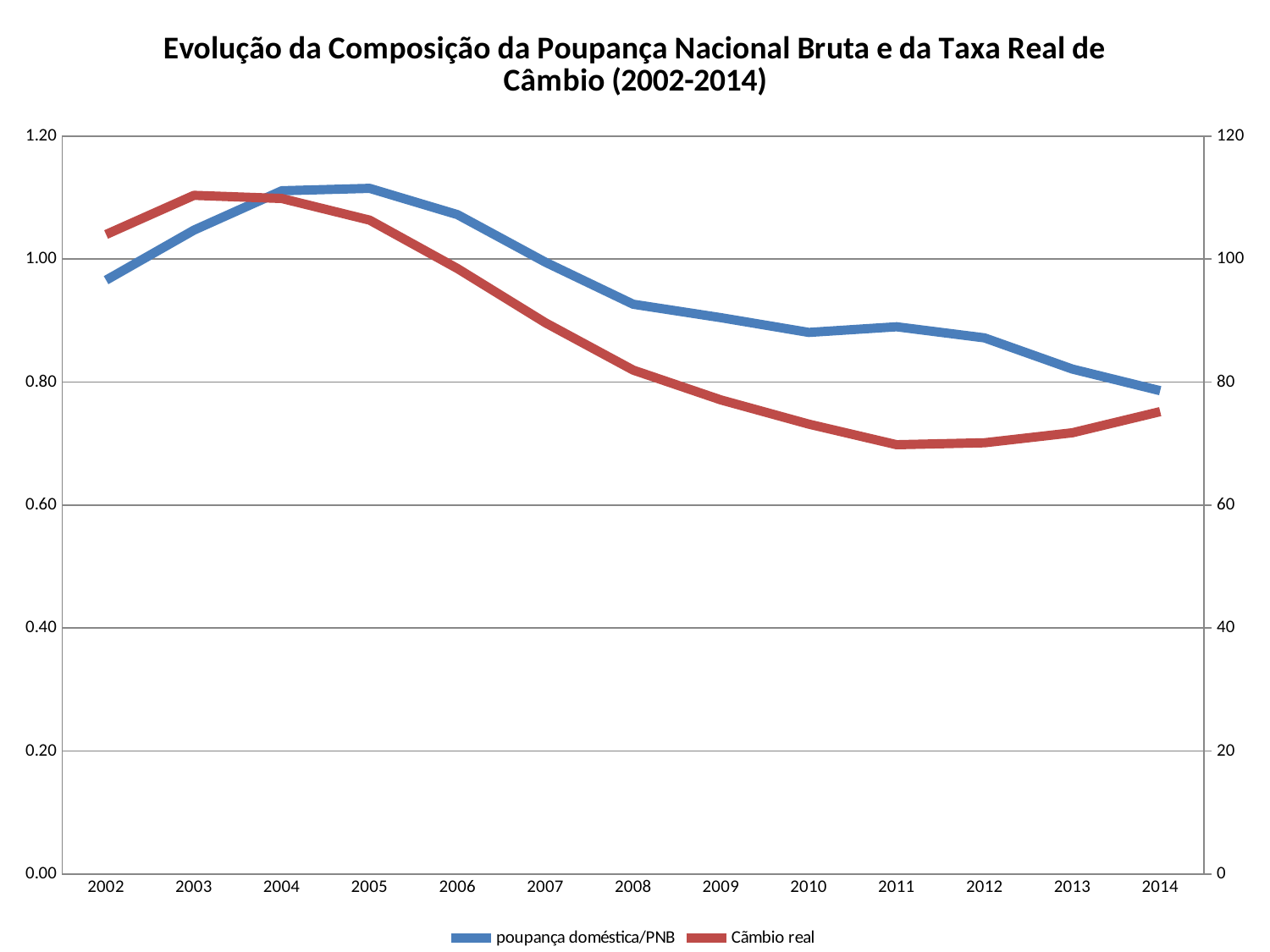
Is the value of poupança doméstica/PNB in 2002 greater or less than 1.00? less Is the value of Câmbio real in 2003 greater or less than 100? greater Which two series are listed in the legend? poupança doméstica/PNB and Cãmbio real In which year is poupança doméstica/PNB at its lowest? 2014 Which is larger for Câmbio real: the value in 2002 or the value in 2014? 2002 What kind of chart is shown on the slide? line chart Is the value of Câmbio real in 2011 greater or less than 80? less How many years are plotted along the x axis? 13 Between 2005 and 2010, does poupança doméstica/PNB rise or fall? fall How many series does the legend list? 2 What is the title of the chart? Evolução da Composição da Poupança Nacional Bruta e da Taxa Real de Câmbio (2002-2014)